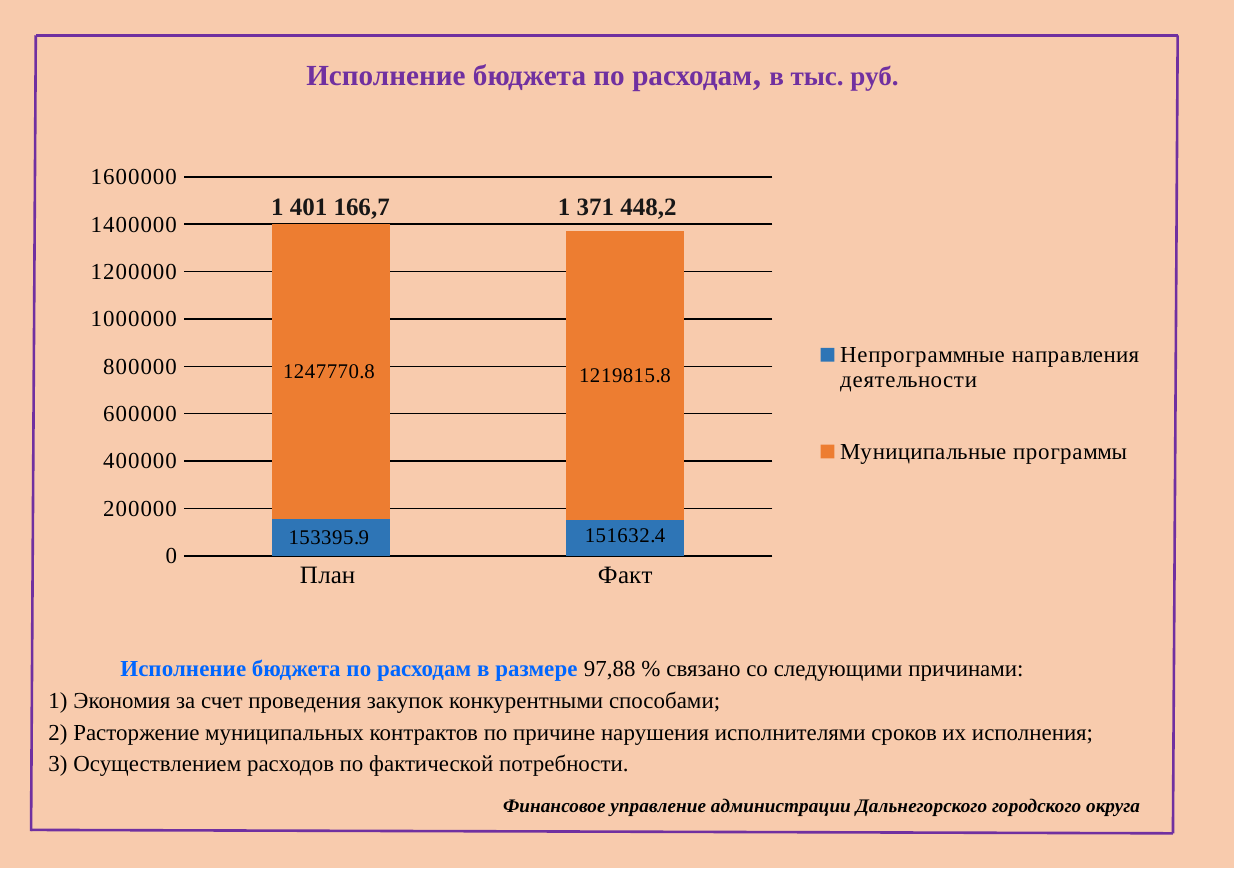
Which series is shown in orange in the legend? Муниципальные программы What is the title of the chart? Исполнение бюджета по расходам, в тыс. руб. How many categories are shown on the x axis? 2 What is the value of Муниципальные программы for План? 1247770.8 What is the total of the stacked bar for План? 1 401 166,7 What kind of chart is shown on the slide? stacked bar chart Which category has the higher value for Муниципальные программы, План or Факт? План What is the value of Непрограммные направления деятельности for Факт? 151632.4 How many series does the legend list? 2 What is the difference between the Муниципальные программы values for План and Факт? 27955.0 What is the total of the stacked bar for Факт? 1 371 448,2 What is the difference between the Непрограммные направления деятельности values for План and Факт? 1763.5